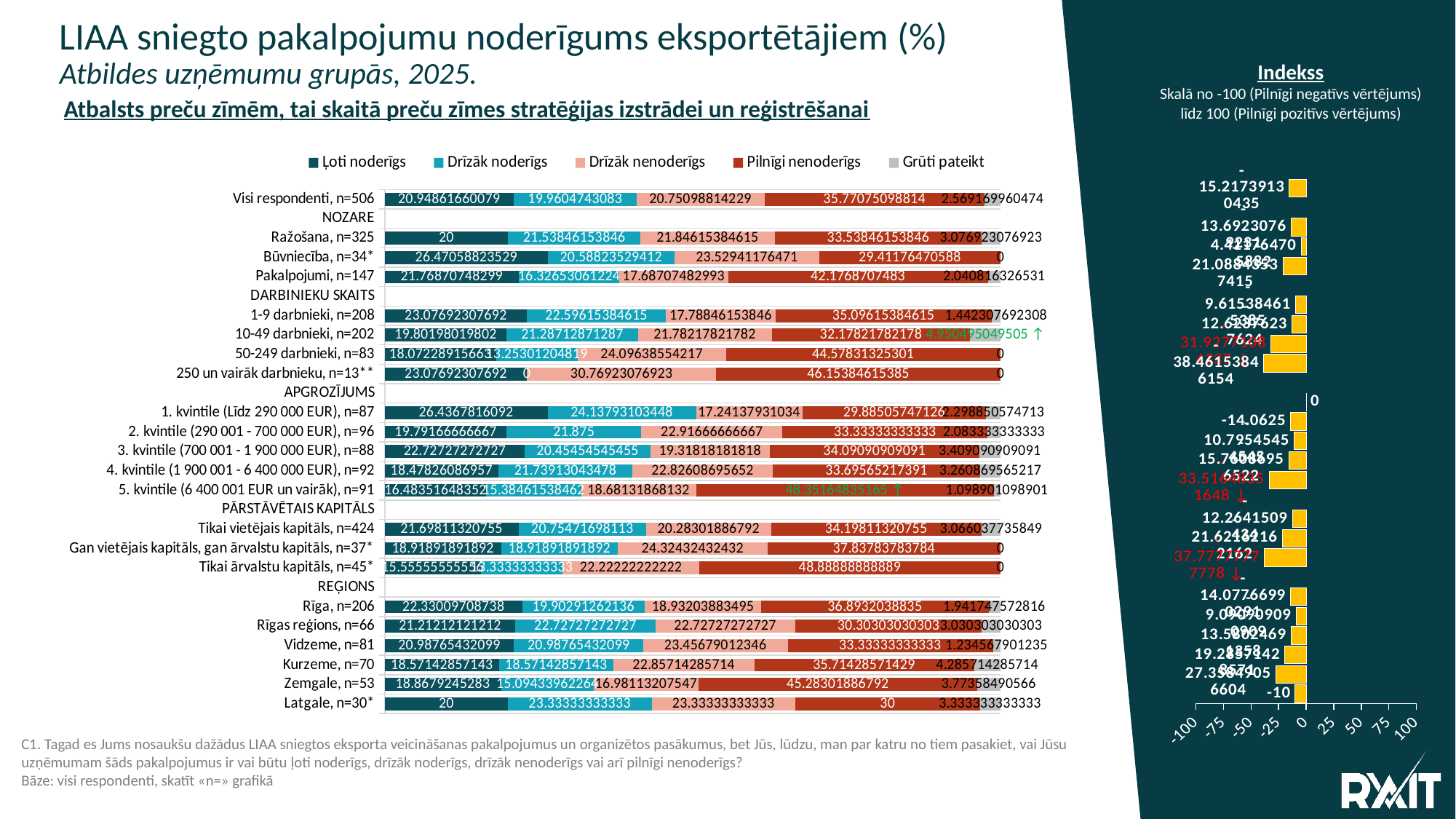
Which has a larger "Ļoti noderīgs" value: Būvniecība, n=34* or Pakalpojumi, n=147? Būvniecība, n=34* What is the value of "Pilnīgi nenoderīgs" for Pakalpojumi, n=147? 42.1768707483 What kind of chart is used to show the responses by company group? Stacked bar chart What is the value of "Ļoti noderīgs" for Ražošana, n=325? 20 Among the REĢIONS groups, which has the highest "Pilnīgi nenoderīgs" value? Zemgale, n=53 How many series does the legend of the stacked bar chart list? 5 What is the value of "Grūti pateikt" for Tikai ārvalstu kapitāls, n=45*? 0 What is the value of "Drīzāk noderīgs" for 250 un vairāk darbinieku, n=13**? 0 How many groups are listed under the REĢIONS section of the chart? 6 Which legend entry is shown in light grey? Grūti pateikt What is the value of "Pilnīgi nenoderīgs" for Latgale, n=30*? 30 What is the difference between the "Drīzāk noderīgs" and "Ļoti noderīgs" values for Latgale, n=30*? 3.33333333333